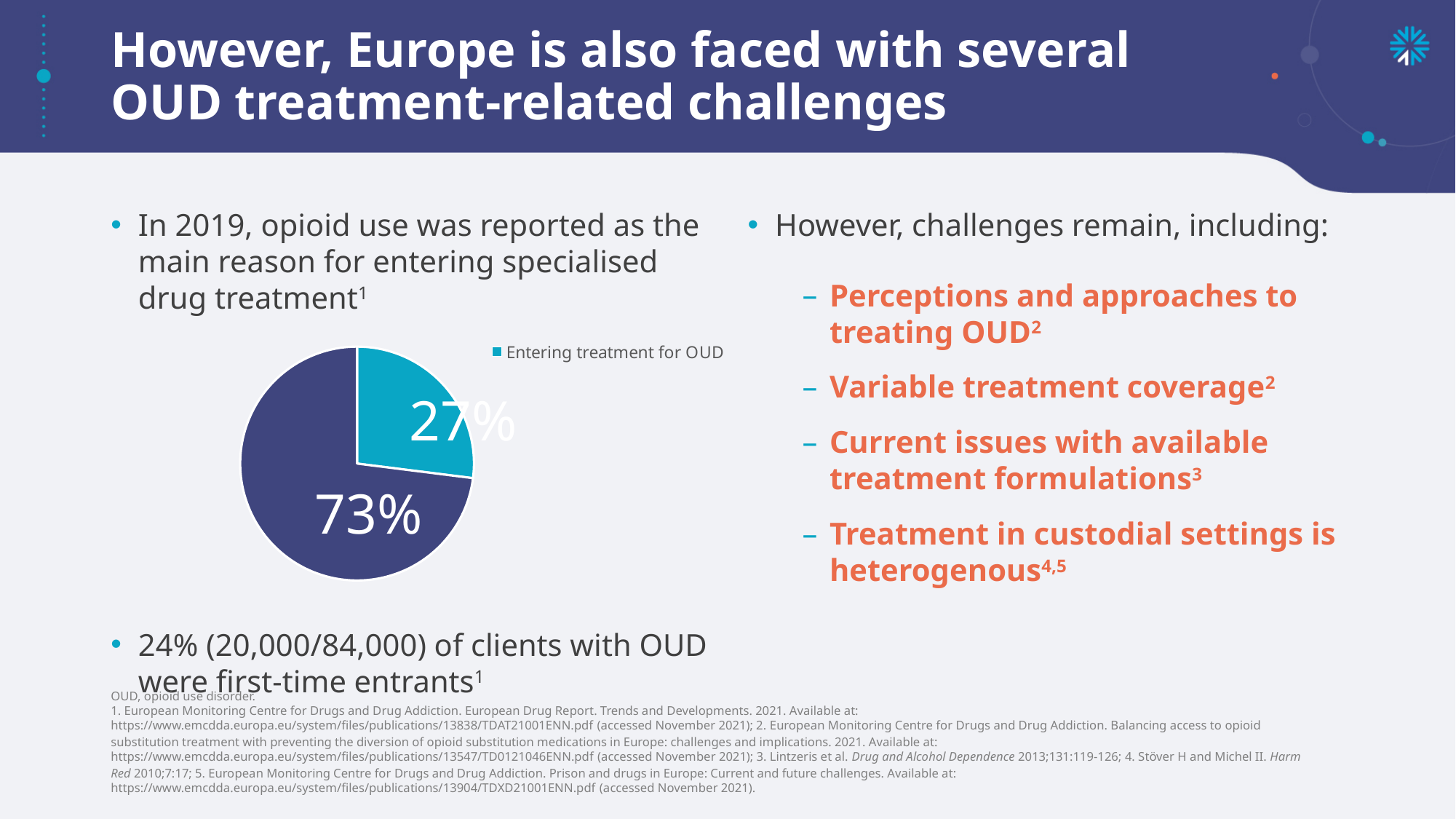
How many slices does the pie chart have? 2 What kind of chart is shown on the slide? pie chart What percentage is shown for the slice labelled 'Entering treatment for OUD' in the pie chart? 27% What do the two slices of the pie chart add up to? 100% What percentage is shown on the larger, dark purple slice of the pie chart? 73% What is the legend entry shown next to the pie chart? Entering treatment for OUD What colour is the 'Entering treatment for OUD' slice in the pie chart? teal Which slice of the pie chart is larger, the 27% slice or the 73% slice? the 73% slice What share of the pie does the 'Entering treatment for OUD' slice represent? 27% Which slice of the pie chart is the smallest? Entering treatment for OUD (27%) What is the difference in percentage points between the two slices of the pie chart? 46 How many entries does the pie chart's legend list? 1